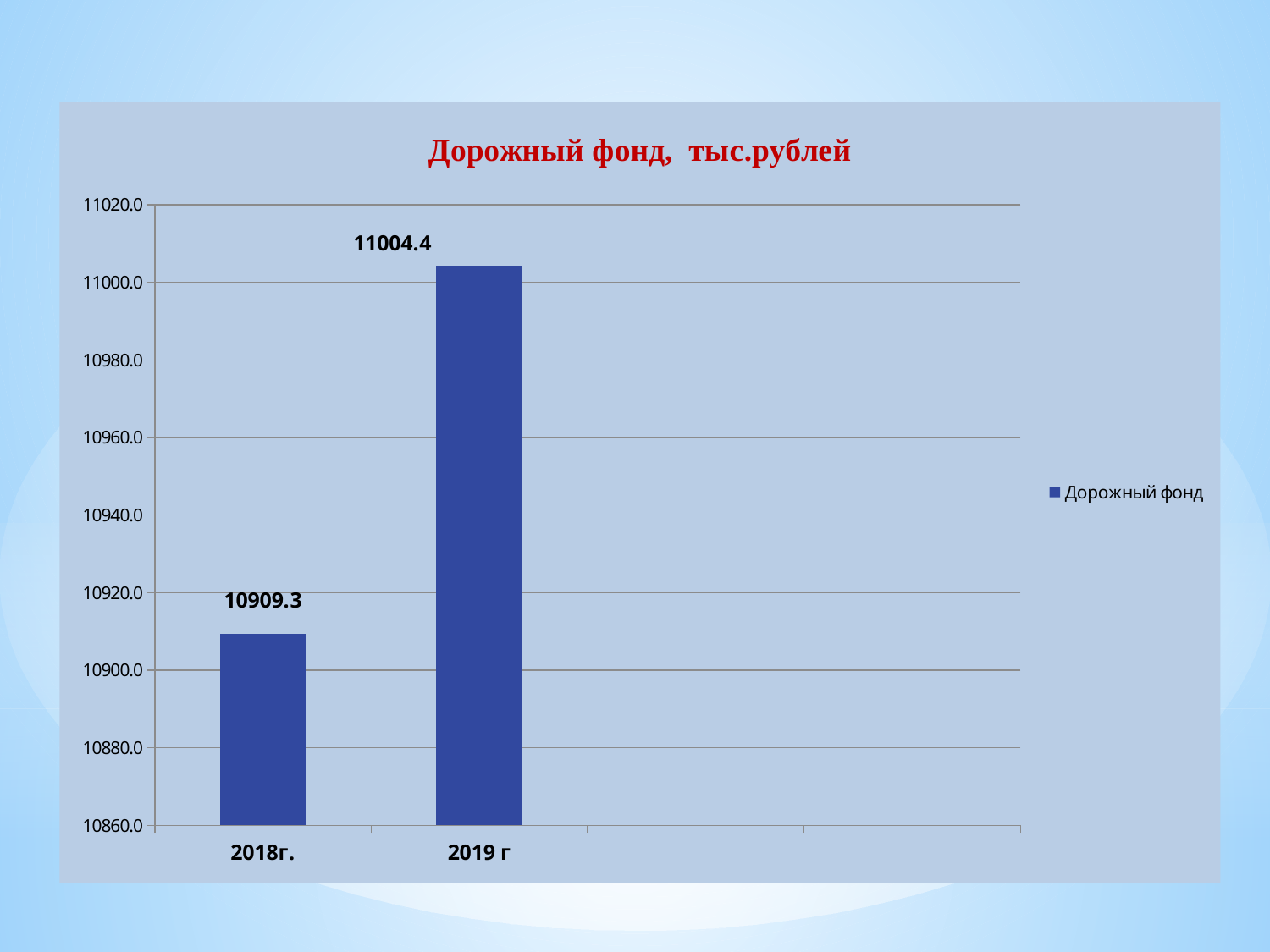
What kind of chart is shown on the slide? bar chart Which year has the highest value? 2019 г What is the difference between the values for 2019 г and 2018г.? 95.1 What is the value for 2019 г? 11004.4 Which is larger, the value for 2018г. or the value for 2019 г? 2019 г How many bars are plotted in the chart? 2 Is the value for 2018г. greater or less than 10920.0? less Which year has the lowest value? 2018г. What is the value for 2018г.? 10909.3 Is the value for 2019 г greater or less than 11000.0? greater What is the title of the chart? Дорожный фонд, тыс.рублей How many series does the legend list? 1